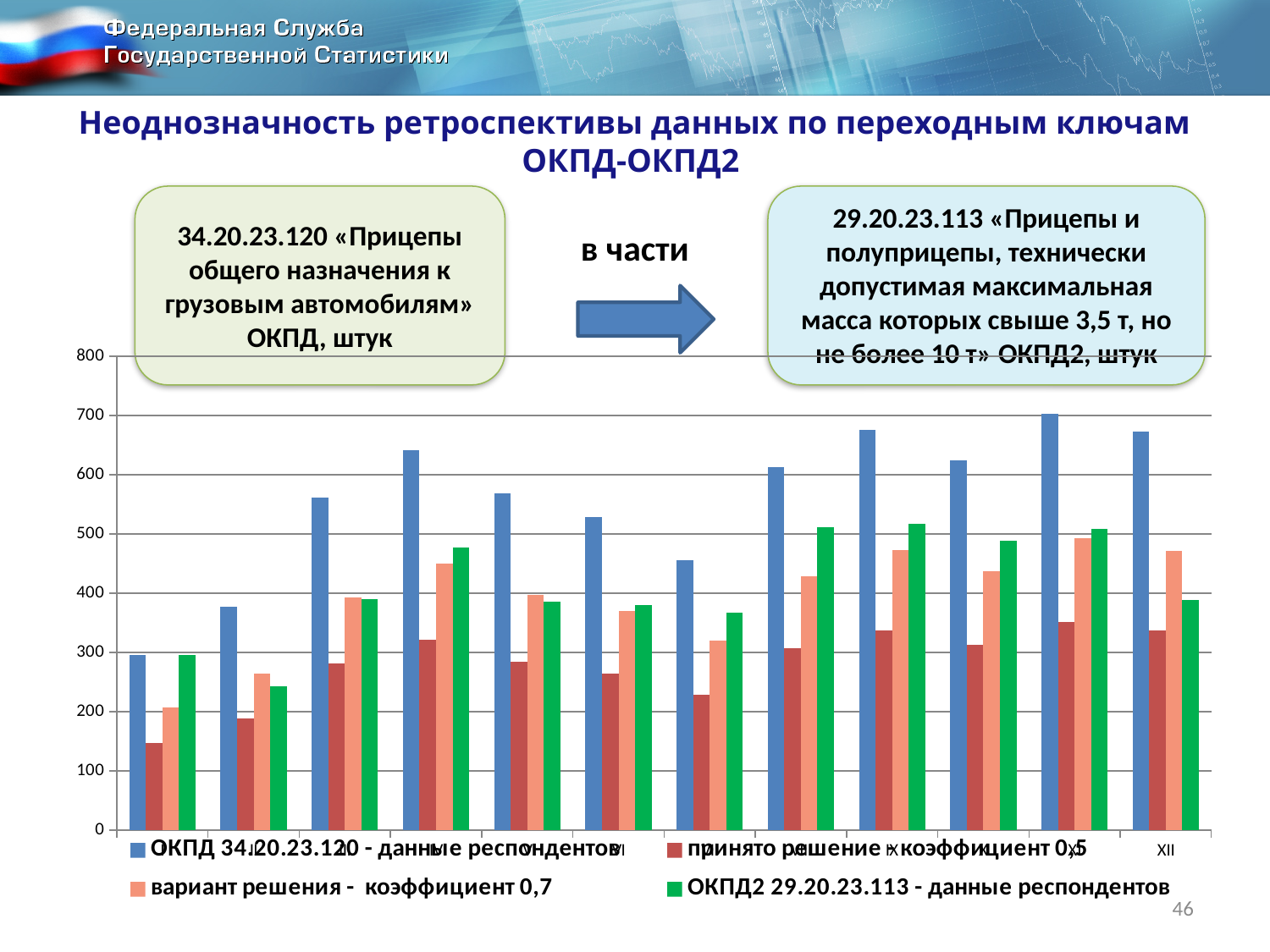
Which series is shown in green in the chart? ОКПД2 29.20.23.113 - данные респондентов Which series has the highest bar in category XII? ОКПД 34.20.23.120 - данные респондентов Is the value of the red series (принято решение - коэффициент 0,5) for category XII greater or less than 300? greater Is the value of the green series (ОКПД2 29.20.23.113) for category XII greater or less than 500? less Which series has the lowest bar in category XII? принято решение - коэффициент 0,5 What kind of chart is shown on the slide? bar chart Is the value of the blue series in the first (leftmost) group greater or less than 200? greater Which series is shown in dark blue in the chart? ОКПД 34.20.23.120 - данные респондентов How many category groups are plotted along the x axis? 12 How many series does the chart legend list? 4 In category XII, which is larger: the orange series (вариант решения - коэффициент 0,7) or the green series (ОКПД2 29.20.23.113)? вариант решения - коэффициент 0,7